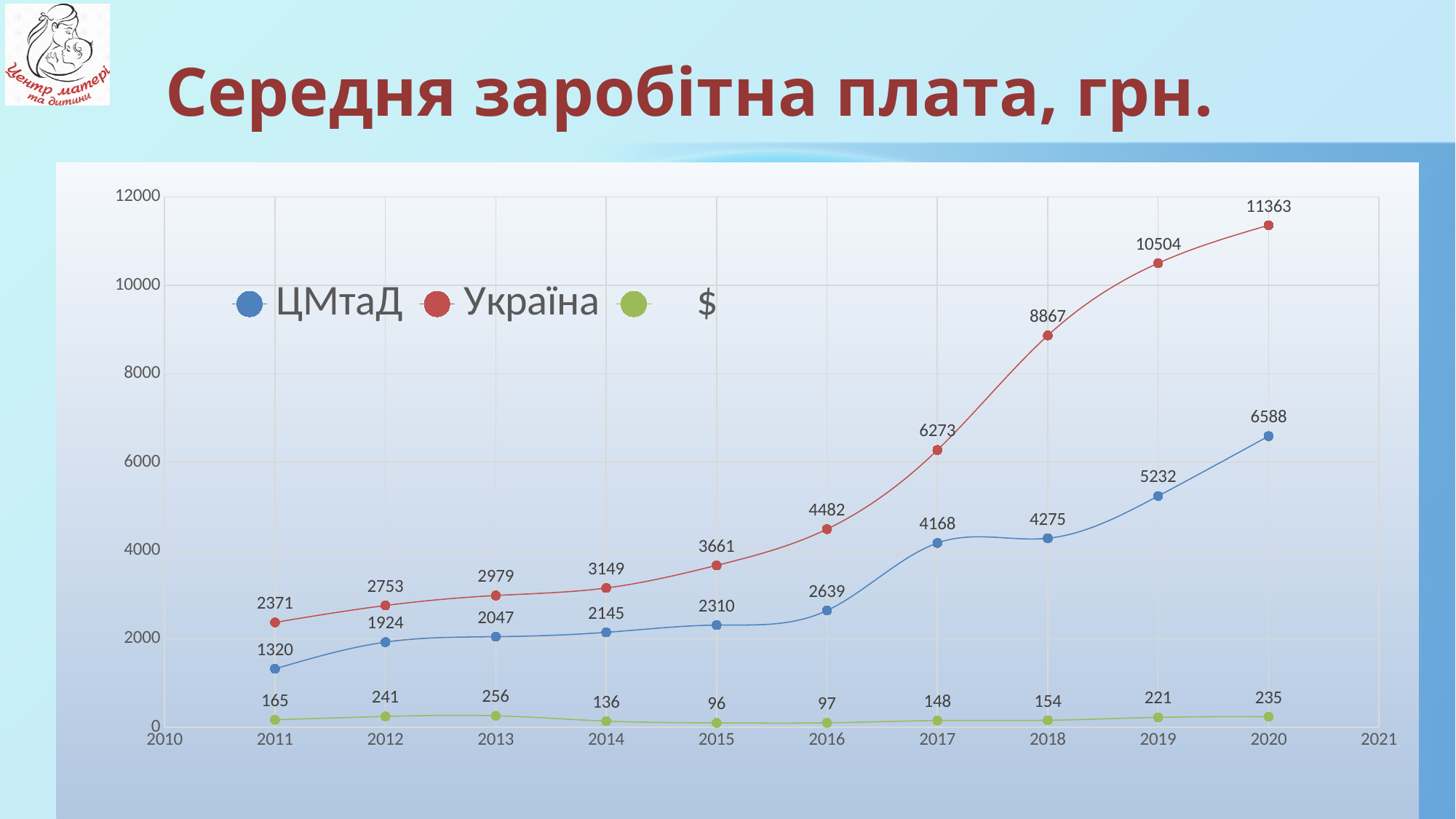
What is the title of the slide? Середня заробітна плата, грн. What is the difference between the Україна and ЦМтаД values in 2020? 4775 In which year is the ЦМтаД series highest? 2020 Which is larger in 2018: the value for Україна or the value for ЦМтаД? Україна What type of chart is shown on the slide? line chart What is the value for Україна in 2020? 11363 In which year is the $ series lowest? 2015 How many years have data points plotted for each series? 10 What is the value for the $ series in 2013? 256 Does the Україна series rise or fall from 2011 to 2020? rise How many series does the legend list? 3 What is the value for ЦМтаД in 2017? 4168